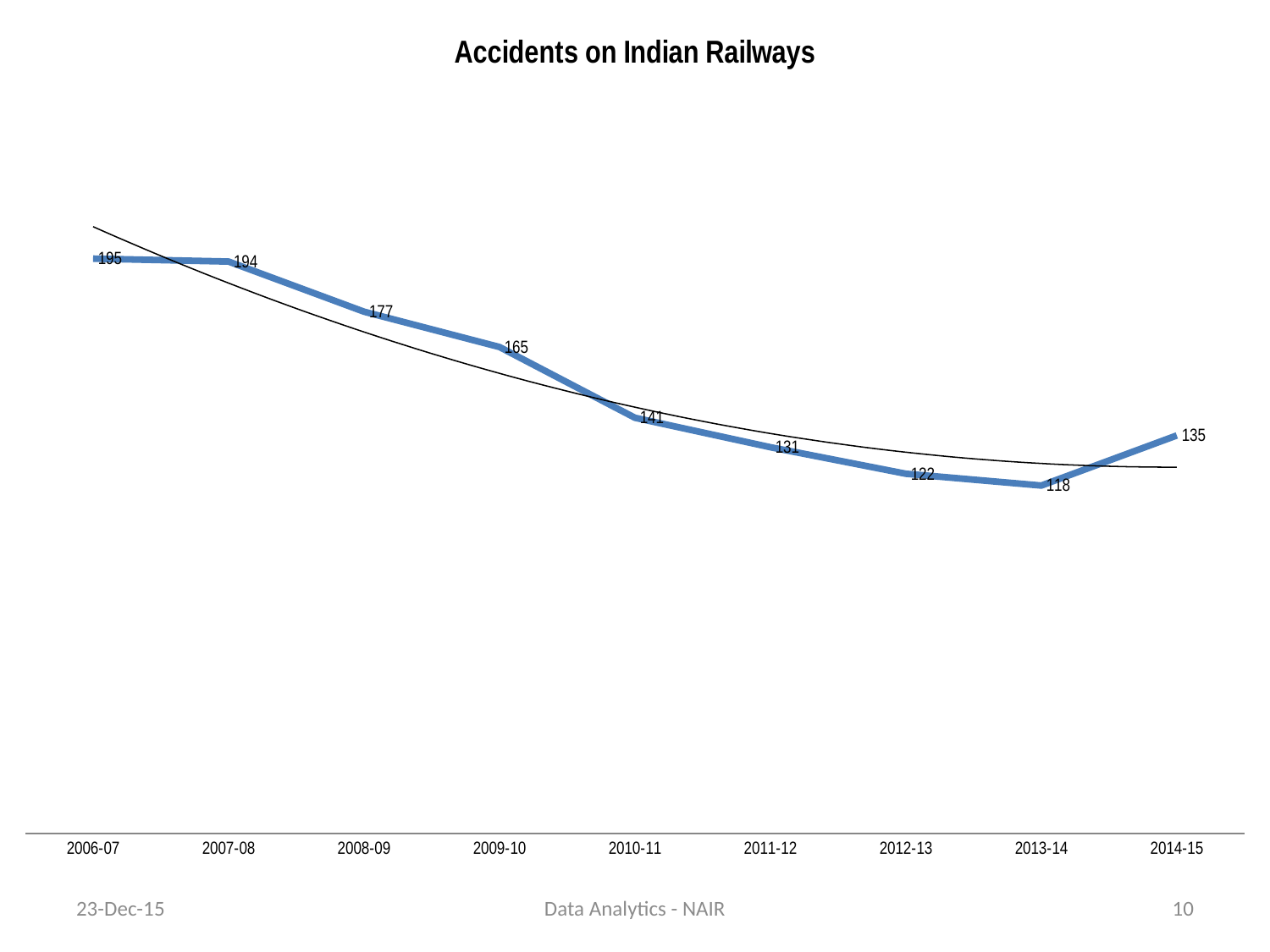
What is the title of the chart? Accidents on Indian Railways How many years are plotted on the x axis? 9 What kind of chart is this? line chart Do the values generally rise or fall from 2006-07 to 2013-14? fall What is the value for 2006-07? 195 What is the difference between the values for 2006-07 and 2013-14? 77 Which year has the lowest value? 2013-14 What is the difference between the values for 2008-09 and 2009-10? 12 What is the value for 2014-15? 135 Which is larger, the value for 2010-11 or the value for 2014-15? 2010-11 Which year has the highest value? 2006-07 What is the value for 2009-10? 165